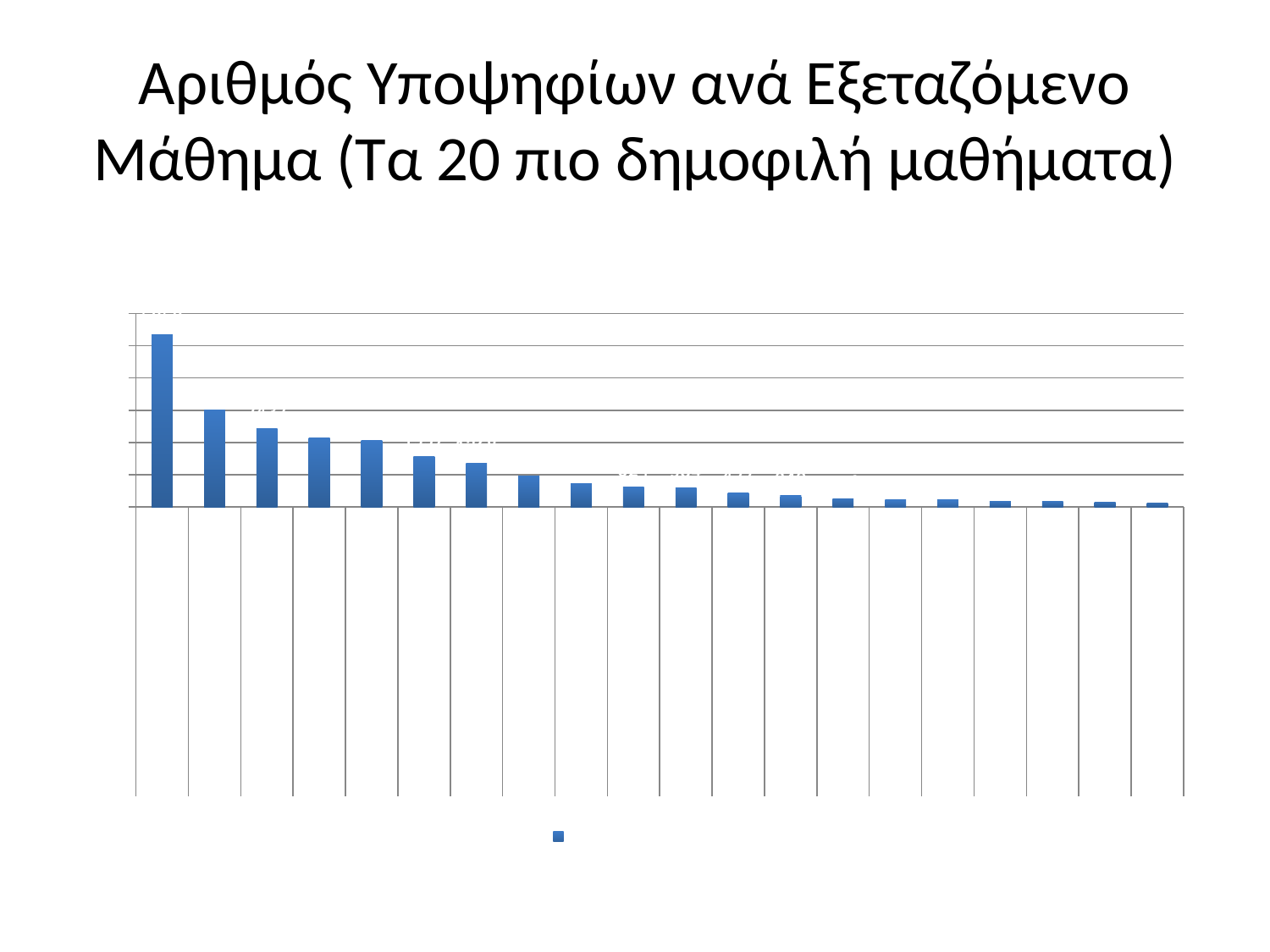
Which is larger, the first bar or the second bar? the first bar Which bar is the lowest in the chart? the rightmost (last) bar Which bar is the highest in the chart? the leftmost (first) bar What is the title of the chart on the slide? Αριθμός Υποψηφίων ανά Εξεταζόμενο Μάθημα (Τα 20 πιο δημοφιλή μαθήματα) Which is larger, the second bar or the tenth bar? the second bar What kind of chart is shown on the slide? bar chart Do the bar values rise or fall from left to right along the x axis? fall What colour are the bars in the chart? blue How many series does the legend list? 1 How many bars are plotted in the chart? 20